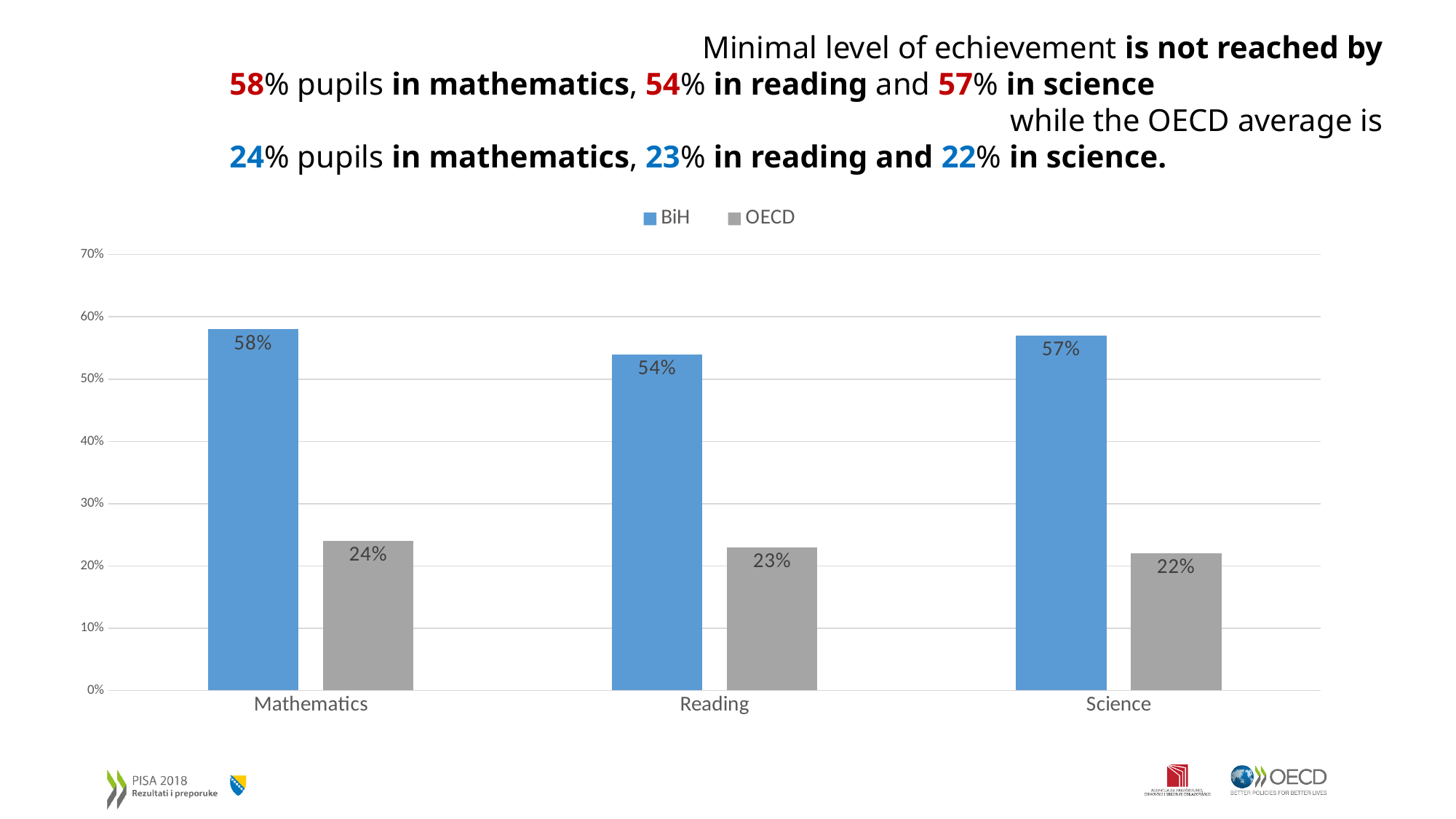
What is the difference between the BiH and OECD values for Mathematics? 34% Which category has the highest BiH value? Mathematics How many series does the legend list? 2 What is the OECD value for Science? 22% What is the OECD value for Reading? 23% Which category has the lowest OECD value? Science How many categories are shown on the x axis? 3 Is the OECD value for Mathematics greater or less than 30%? less What kind of chart is shown on the slide? bar chart What is the BiH value for Mathematics? 58% What is the difference between the BiH values for Mathematics and Reading? 4% Which is larger, the BiH value for Reading or the BiH value for Science? Science